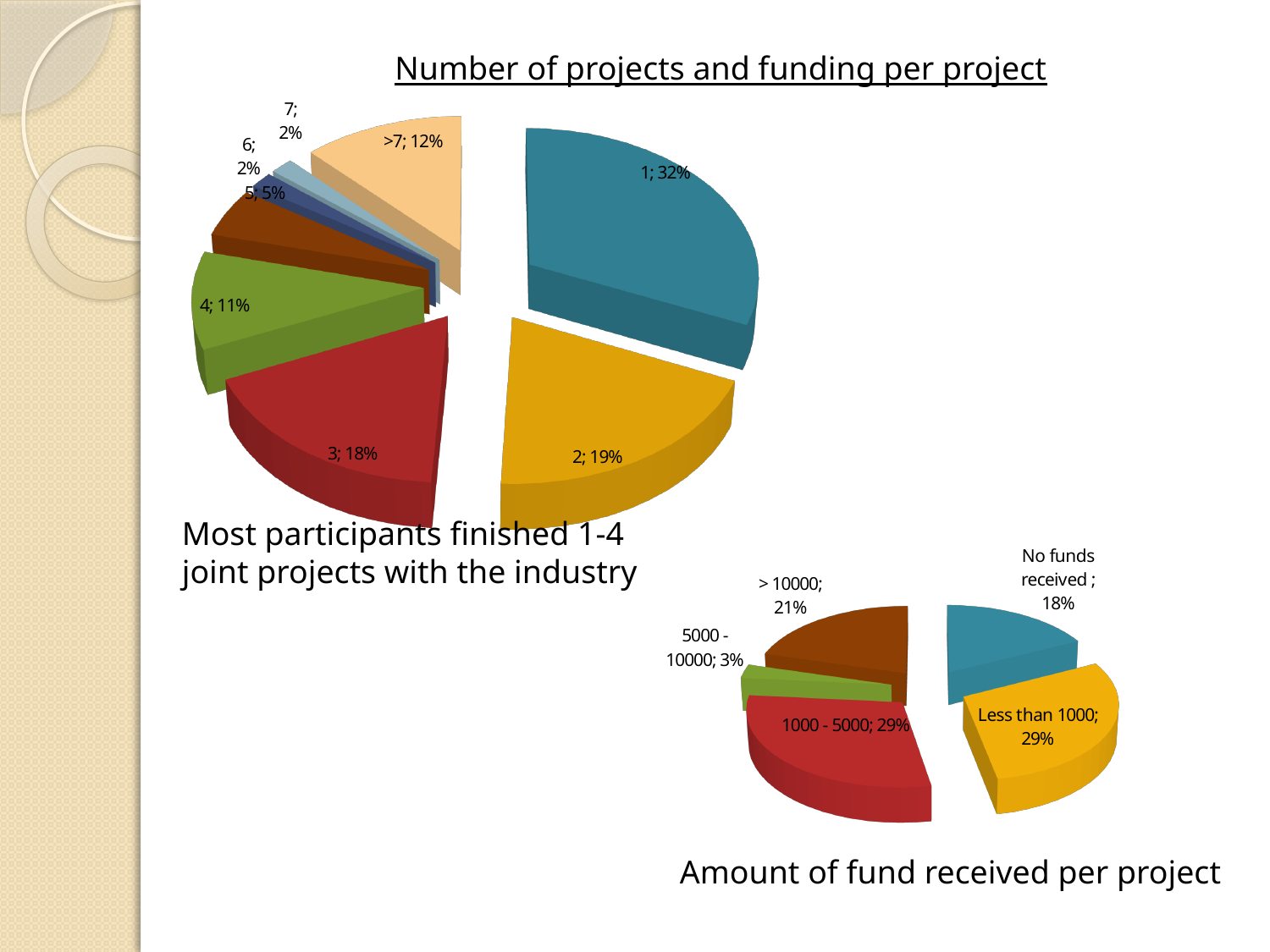
In the 'Amount of fund received per project' chart, how many categories are shown? 5 In the top-left pie chart (number of projects), what share of participants finished 4 projects? 11% In the top-left pie chart (number of projects), what is the difference in percentage points between the shares for 2 projects and 3 projects? 1 In the top-left pie chart (number of projects), which is larger: the share for >7 projects or the share for 4 projects? >7 In the 'Amount of fund received per project' chart, what share of projects received more than 10000? 21% In the top-left pie chart (number of projects), which category has the largest share? 1 In the top-left pie chart (number of projects), what share of participants finished 1 project? 32% What kind of chart is the 'Amount of fund received per project' chart at the bottom right? Pie chart In the 'Amount of fund received per project' chart, what share of projects received no funds? 18% What is the title shown above the top-left pie chart? Number of projects and funding per project In the 'Amount of fund received per project' chart, which category has the smallest share? 5000 - 10000 In the top-left pie chart (number of projects), how many slices does the pie have? 8